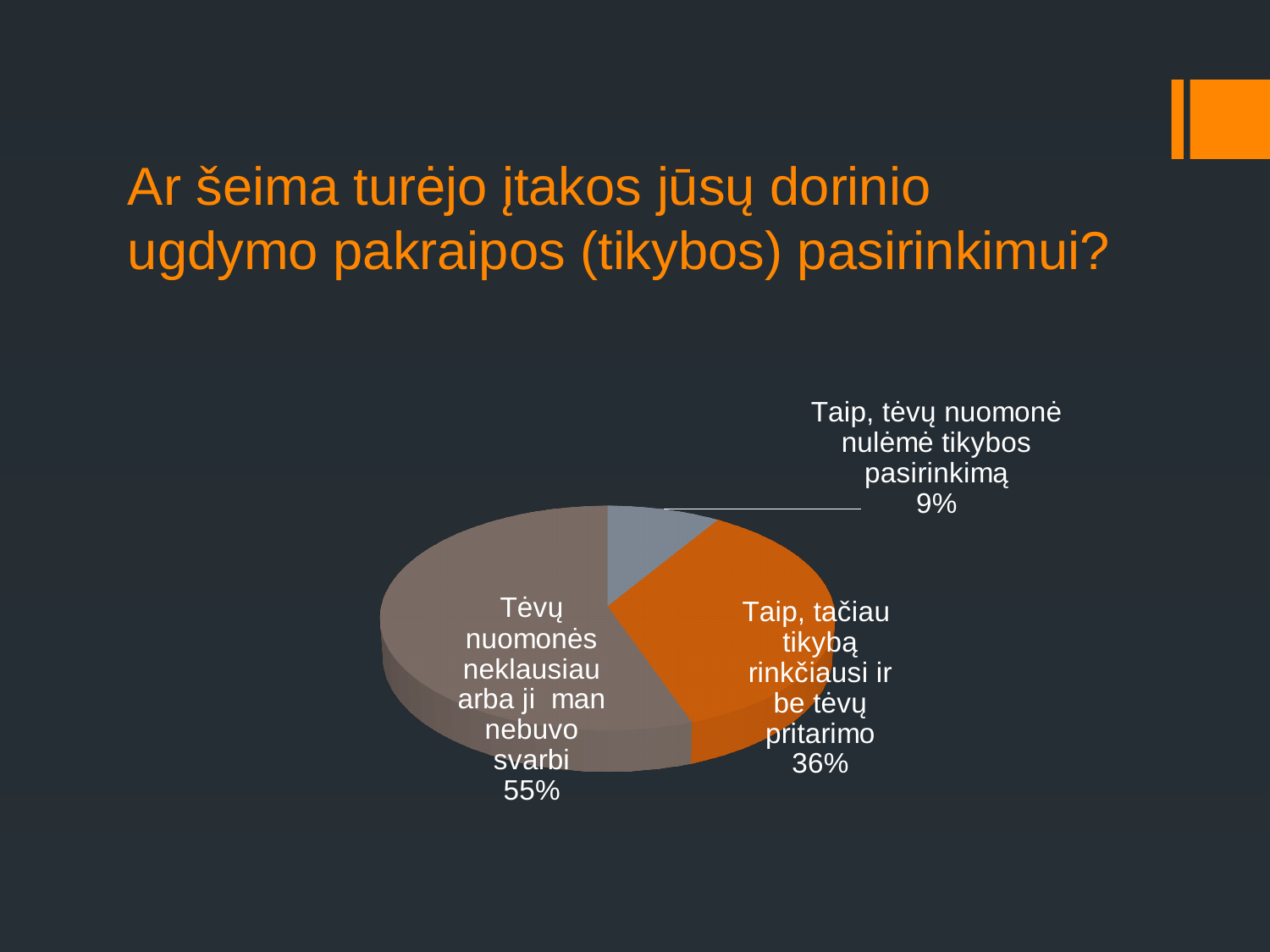
What is the difference in percentage points between the "Tėvų nuomonės neklausiau arba ji man nebuvo svarbi" slice and the "Taip, tačiau tikybą rinkčiausi ir be tėvų pritarimo" slice? 19 percentage points What share of the pie is labelled "Taip, tačiau tikybą rinkčiausi ir be tėvų pritarimo"? 36% Which slice of the pie is the smallest? Taip, tėvų nuomonė nulėmė tikybos pasirinkimą What colour is the slice labelled "Taip, tačiau tikybą rinkčiausi ir be tėvų pritarimo"? orange What share of the pie is labelled "Taip, tėvų nuomonė nulėmė tikybos pasirinkimą"? 9% Which slice of the pie is the largest? Tėvų nuomonės neklausiau arba ji man nebuvo svarbi What kind of chart is shown on the slide? pie chart How many slices does the pie chart have? 3 What share of the pie is labelled "Tėvų nuomonės neklausiau arba ji man nebuvo svarbi"? 55% Which is larger: the "Taip, tačiau tikybą rinkčiausi ir be tėvų pritarimo" slice or the "Taip, tėvų nuomonė nulėmė tikybos pasirinkimą" slice? Taip, tačiau tikybą rinkčiausi ir be tėvų pritarimo What is the title of the slide containing the pie chart? Ar šeima turėjo įtakos jūsų dorinio ugdymo pakraipos (tikybos) pasirinkimui? What is the difference in percentage points between the "Taip, tačiau tikybą rinkčiausi ir be tėvų pritarimo" slice and the "Taip, tėvų nuomonė nulėmė tikybos pasirinkimą" slice? 27 percentage points